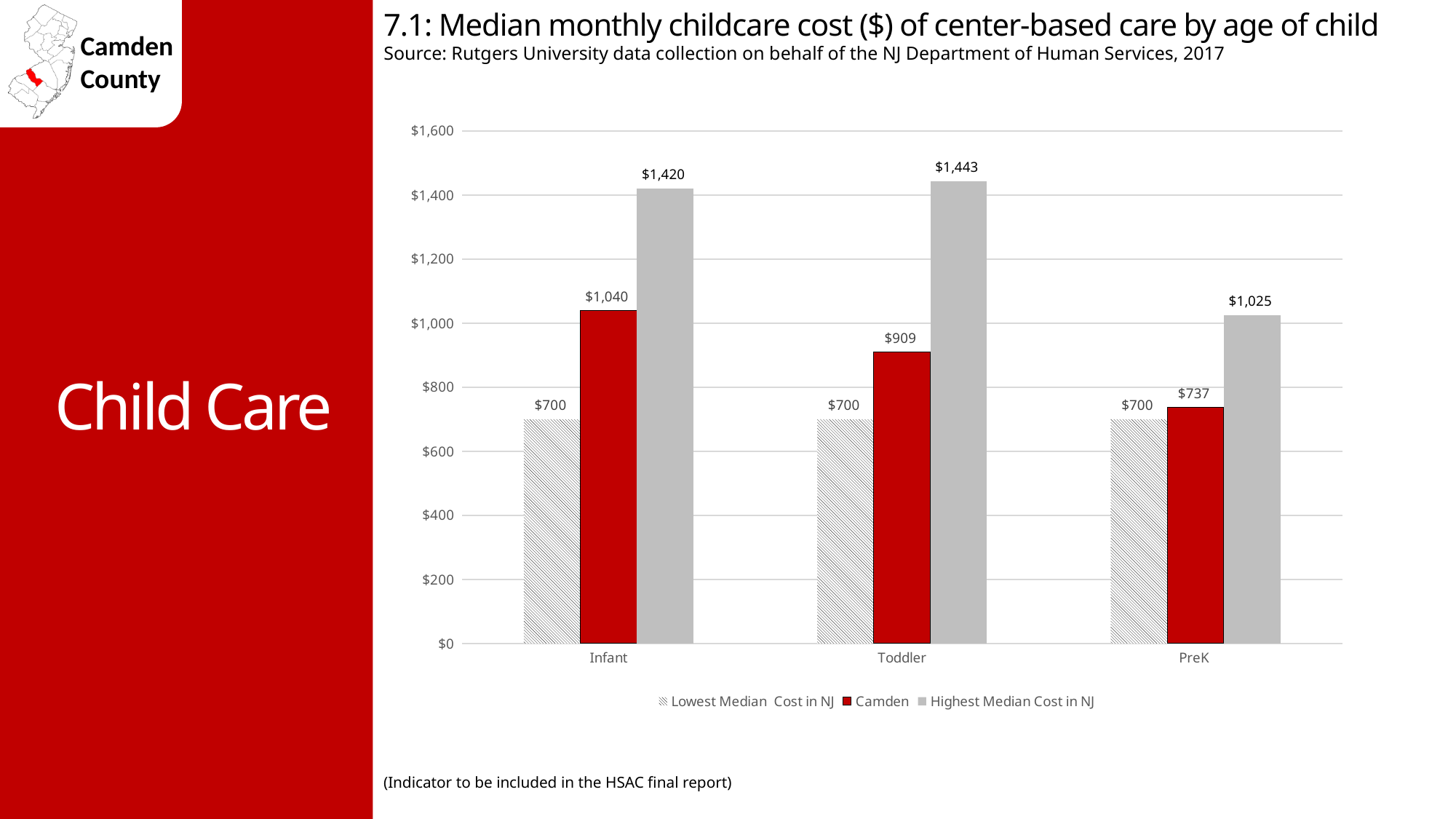
What kind of chart is shown on the slide? Bar chart What is the Camden median monthly childcare cost for Infant care? $1,040 Which age group has the lowest Highest Median Cost in NJ? PreK What is the Lowest Median Cost in NJ for Toddler care? $700 How many series does the legend list? 3 What is the difference between the Camden cost for Toddler care and the Camden cost for PreK? $172 What is the difference between the Highest Median Cost in NJ and the Camden cost for Infant care? $380 What is the Camden value for PreK? $737 How many age groups are shown on the x axis? 3 Which is larger: the Camden cost for Toddler care or the Highest Median Cost in NJ for PreK? Highest Median Cost in NJ for PreK What is the Highest Median Cost in NJ for Toddler care? $1,443 Which age group has the highest Camden median monthly cost? Infant